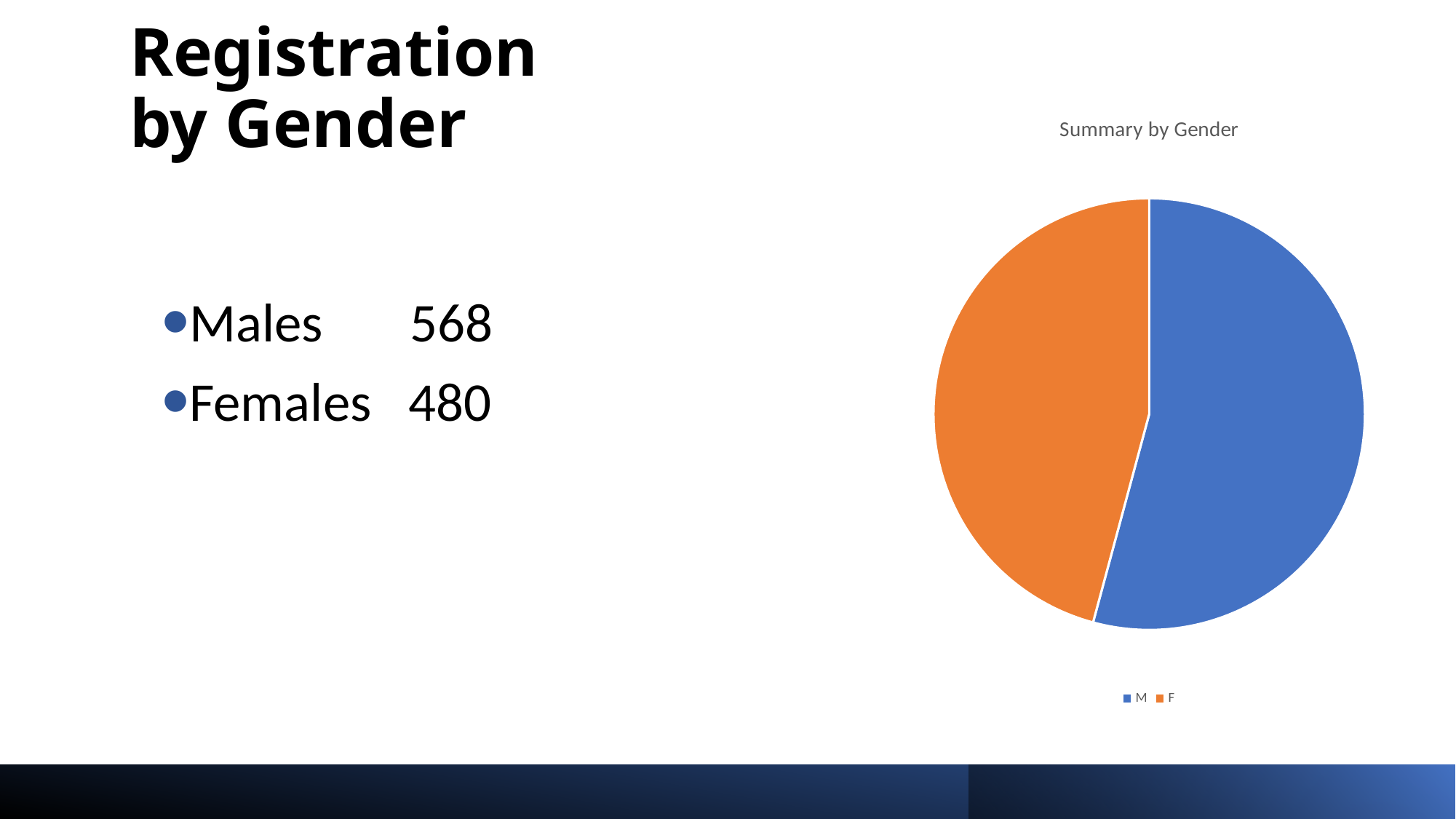
Which is larger, the M slice or the F slice? M What is the difference between the Males and Females registration values? 88 What is the registration value for Males shown on the slide? 568 Which slice of the pie chart is the largest? M What is the title of the chart? Summary by Gender What type of chart is shown on the slide? pie chart How many slices does the pie chart have? 2 What colour is the M slice in the pie chart? blue How many entries does the chart legend list? 2 What is the registration value for Females shown on the slide? 480 Which slice of the pie chart is the smallest? F